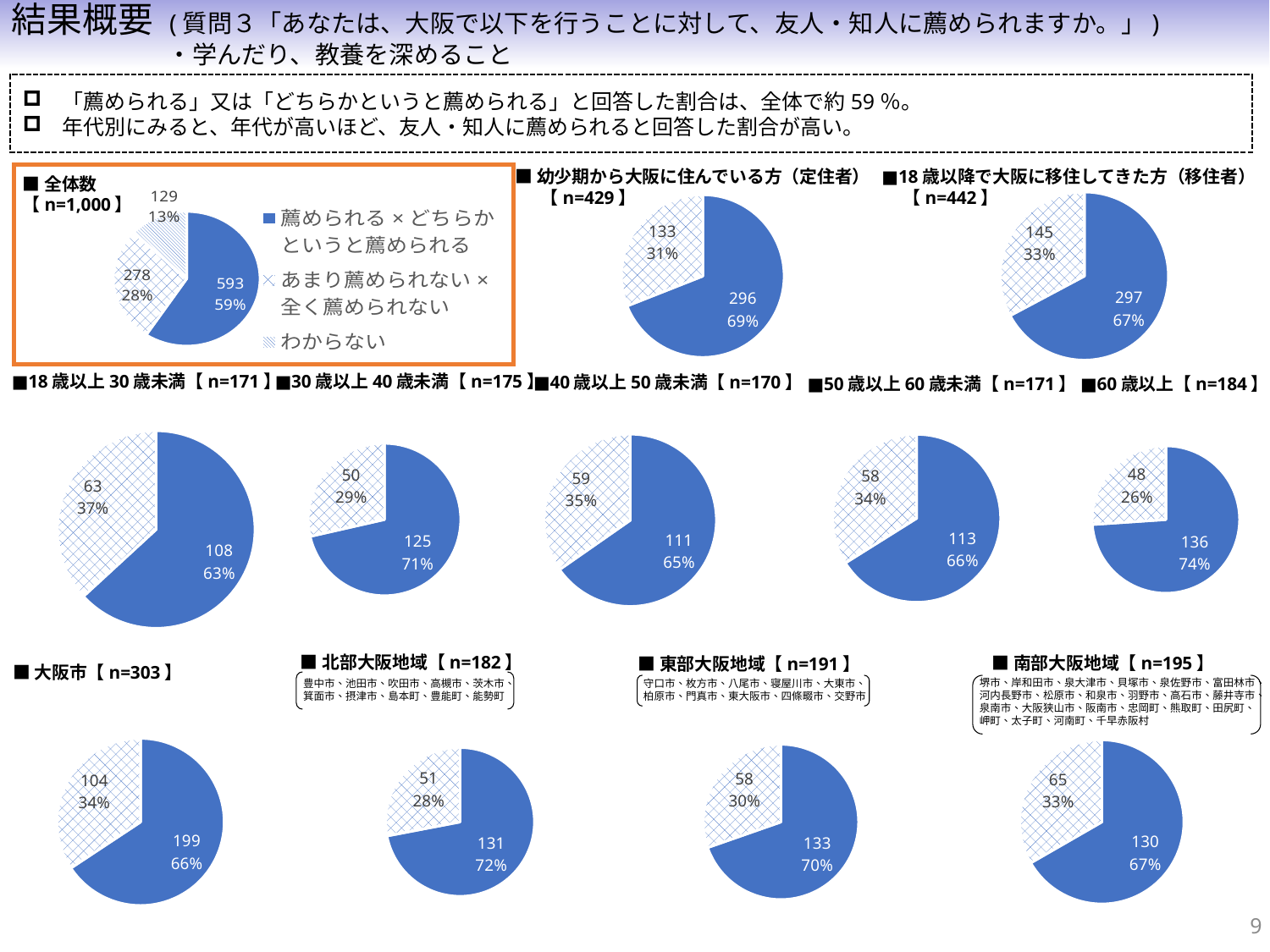
In the 全体数【n=1,000】 pie chart, what share does わからない have? 13% Which age-group pie chart shows the highest share for the larger slice: 18歳以上30歳未満, 30歳以上40歳未満, 40歳以上50歳未満, 50歳以上60歳未満, or 60歳以上? 60歳以上 In the 東部大阪地域【n=191】 pie chart, how many slices are there? 2 In the 全体数【n=1,000】 pie chart, what is the value for 薦められる×どちらかというと薦められる? 593 How many entries does the legend of the 全体数【n=1,000】 pie chart list? 3 In the 幼少期から大阪に住んでいる方（定住者）【n=429】 pie chart, what is the value of the larger slice? 296 In the 60歳以上【n=184】 pie chart, what is the value of the smaller slice? 48 In the 30歳以上40歳未満【n=175】 pie chart, what is the difference between the two slice values? 75 In the 大阪市【n=303】 pie chart, what is the value of the larger slice? 199 Which has a larger share for the larger slice: the 北部大阪地域【n=182】 pie chart or the 南部大阪地域【n=195】 pie chart? 北部大阪地域 In the 18歳以降で大阪に移住してきた方（移住者）【n=442】 pie chart, what share does the smaller slice have? 33% What kind of chart is used for 幼少期から大阪に住んでいる方（定住者）【n=429】? pie chart